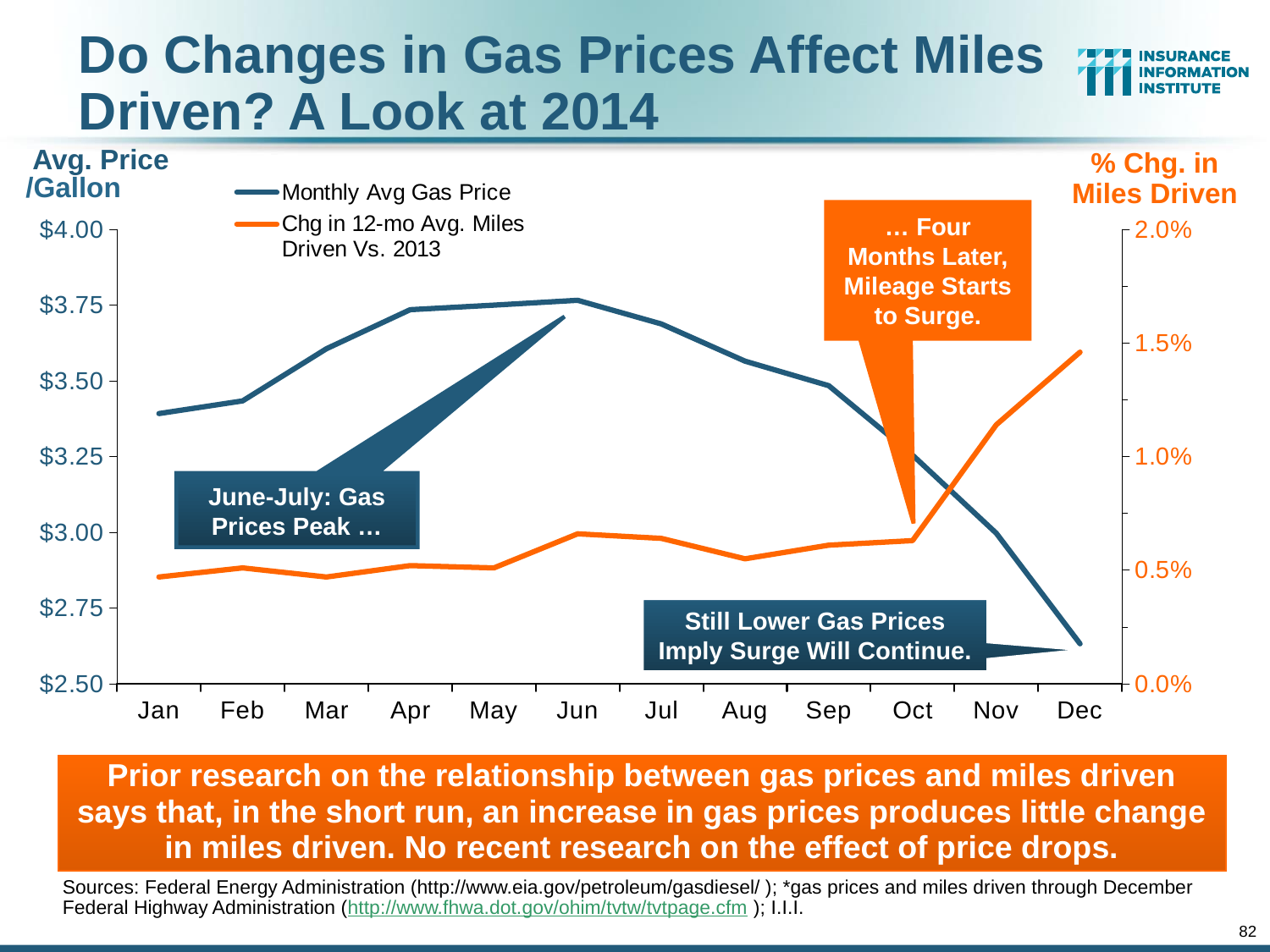
Which month has the highest value for Chg in 12-mo Avg. Miles Driven Vs. 2013? Dec Which is larger, the Monthly Avg Gas Price in Mar or in Nov? Mar Is the Chg in 12-mo Avg. Miles Driven Vs. 2013 for Nov greater or less than 1.0%? greater What is the label on the right-hand vertical axis? % Chg. in Miles Driven How many series does the chart's legend list? 2 Is the Monthly Avg Gas Price for Dec greater or less than $2.75? less Is the Monthly Avg Gas Price for Jun greater or less than $3.50? greater How many months are plotted along the x axis? 12 Does the Monthly Avg Gas Price rise or fall from Jun to Dec? Fall What kind of chart is shown on the slide? Line chart Which month has the lowest Monthly Avg Gas Price? Dec